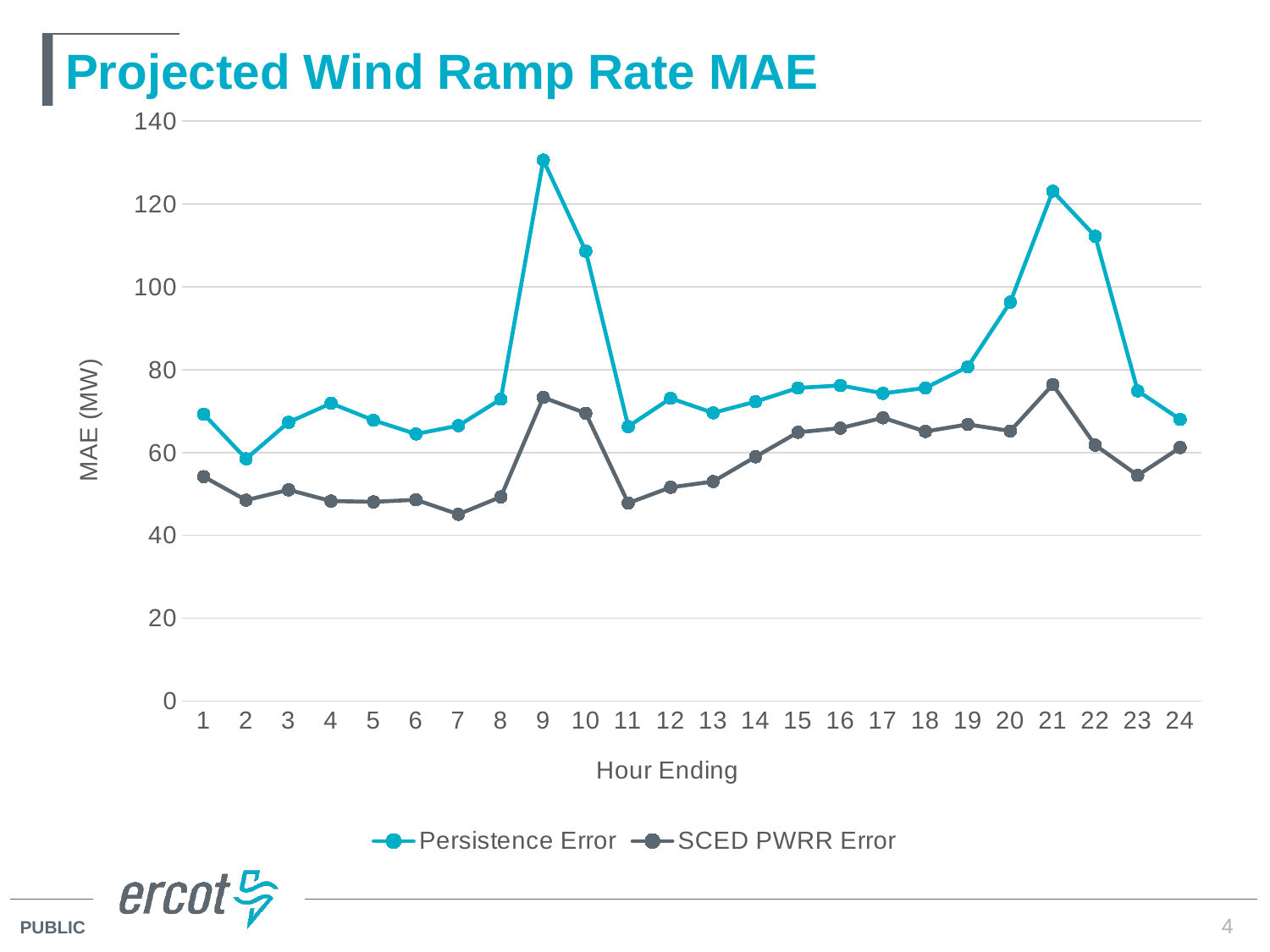
At which hour ending is the Persistence Error highest? 9 At which hour ending is the Persistence Error lowest? 2 How many hour-ending points are plotted along the x axis? 24 At hour ending 9, which series has the higher MAE, Persistence Error or SCED PWRR Error? Persistence Error At which hour ending is the SCED PWRR Error lowest? 7 Is the Persistence Error at hour ending 9 greater or less than 120? greater Is the Persistence Error at hour ending 21 greater or less than 100? greater What kind of chart is shown on the slide? line chart Is the SCED PWRR Error at hour ending 7 greater or less than 60? less What is the label of the y axis? MAE (MW) Does the Persistence Error rise or fall from hour ending 21 to hour ending 24? fall How many series does the legend list? 2